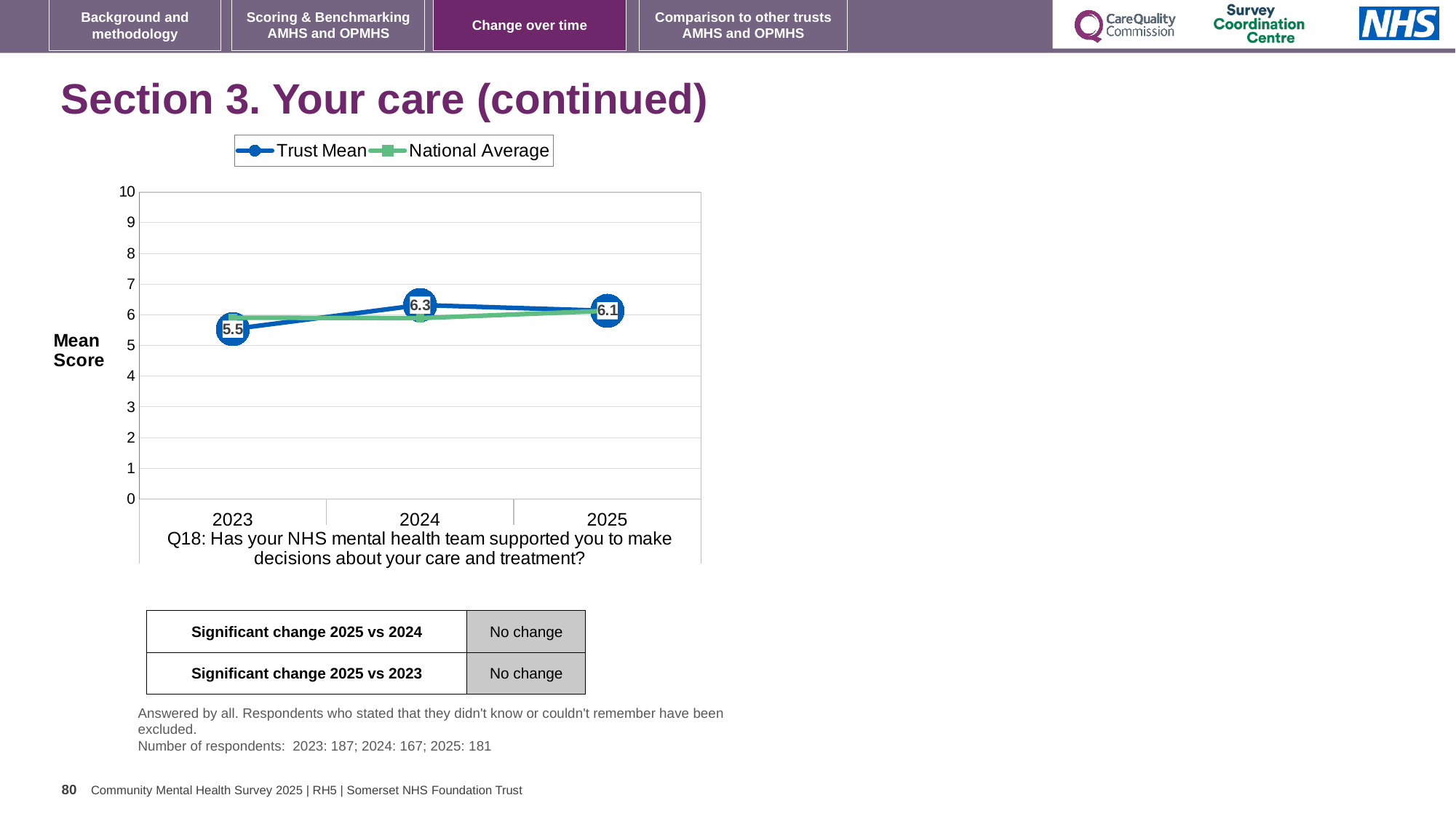
Does the Trust Mean rise or fall from 2023 to 2024? rise What kind of chart is shown on the slide? line chart Which is larger, the Trust Mean in 2023 or in 2024? 2024 In which year is the Trust Mean highest? 2024 How many years are plotted on the x axis? 3 In which year is the Trust Mean lowest? 2023 Is the National Average value for 2023 greater or less than 5? greater How many series does the legend list? 2 What is the Trust Mean score for 2023? 5.5 What is the difference between the Trust Mean in 2024 and in 2023? 0.8 What is the Trust Mean score for 2024? 6.3 What is the Trust Mean score for 2025? 6.1